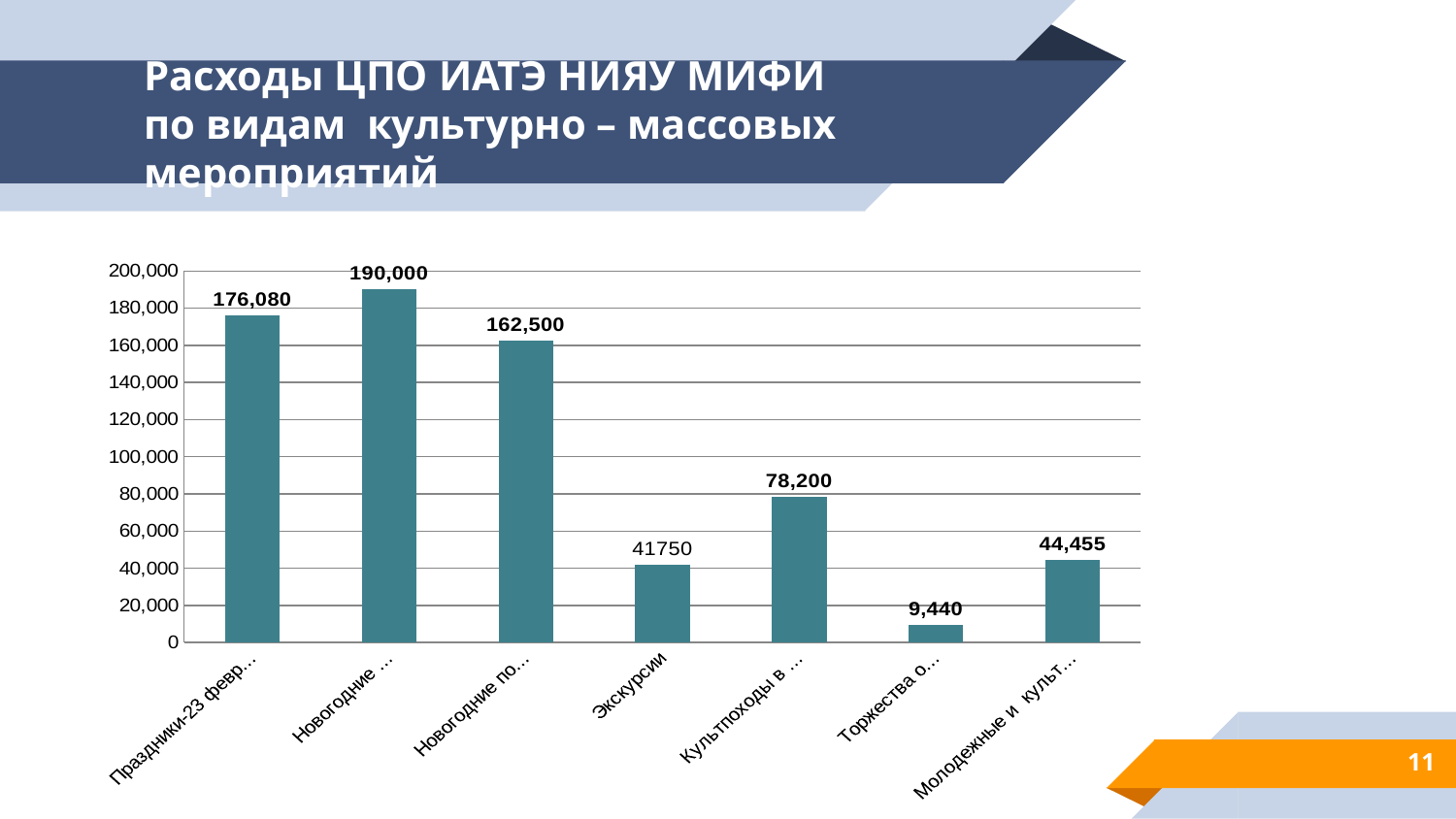
Which category has the highest value? Новогодние ... (second bar) What is the value of the first bar from the left (Праздники-23 февр...)? 176,080 How many bars (categories) does the chart show? 7 What is the difference between the first bar (176,080) and the third bar (162,500)? 13,580 What is the value of the last bar on the right (Молодежные и культ...)? 44,455 Which is larger: the value for Экскурсии or the value for Культпоходы в ...? Культпоходы в ... What is the difference between the highest bar (190,000) and the lowest bar (9,440)? 180,560 What is the value of the bar labelled Торжества о...? 9,440 What is the value for Экскурсии? 41750 What kind of chart is shown on the slide? bar chart Which category has the lowest value? Торжества о... (sixth bar) What is the value of the second bar from the left (Новогодние ...)? 190,000